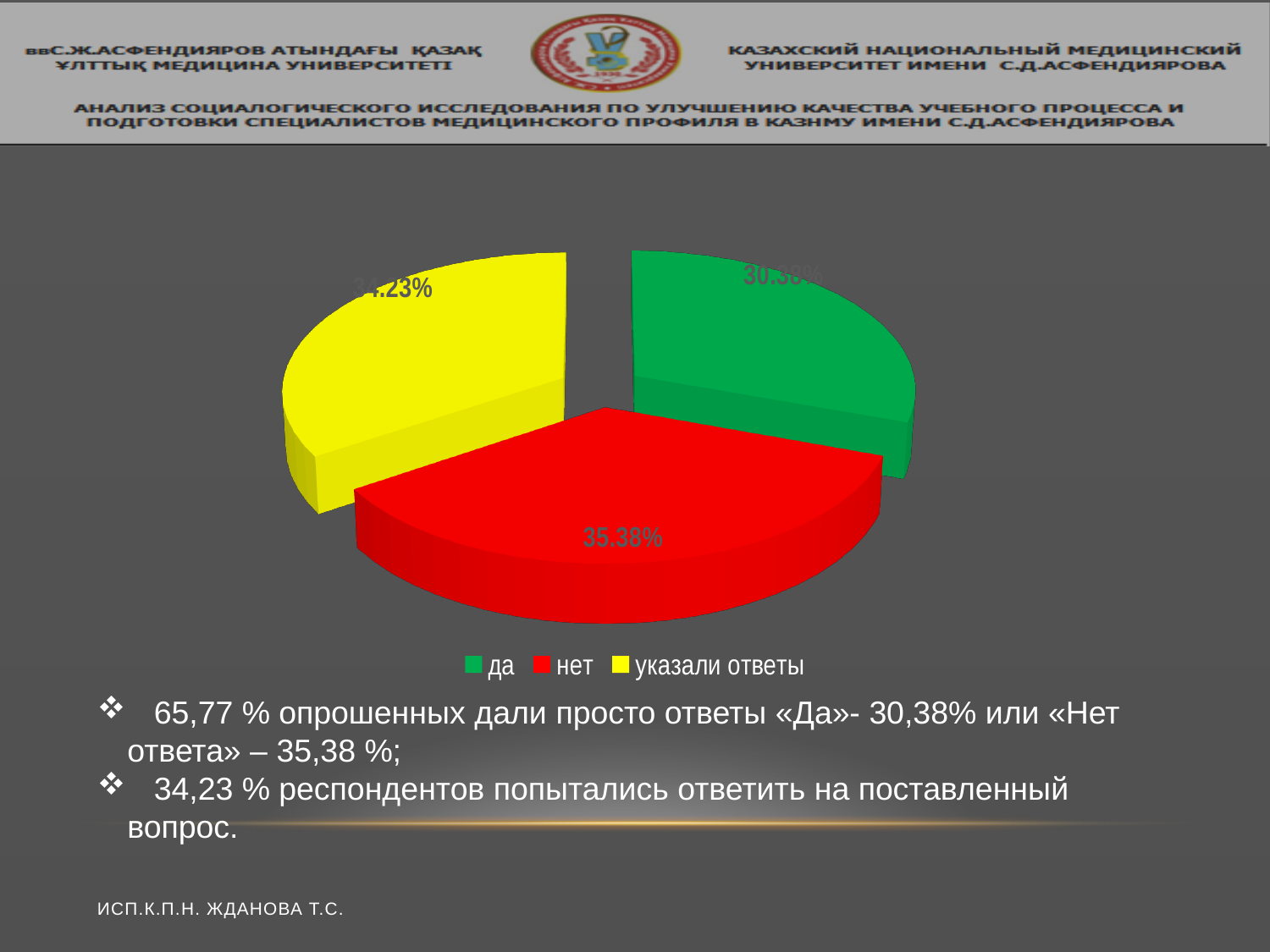
How many entries does the chart legend list? 3 What percentage of the pie chart is the slice for "указали ответы"? 34.23% Which category has the largest slice in the pie chart? нет Which category has the smallest slice in the pie chart? да What is the difference in percentage points between the "указали ответы" slice and the "да" slice? 3.85% What is the difference in percentage points between the "нет" slice and the "да" slice? 5% What type of chart is shown on the slide? Pie chart Which slice is larger, "нет" or "да"? нет How many slices does the pie chart have? 3 What percentage of the pie chart is the slice for "да"? 30.38% What colour is the "нет" slice in the pie chart? Red What percentage of the pie chart is the slice for "нет"? 35.38%